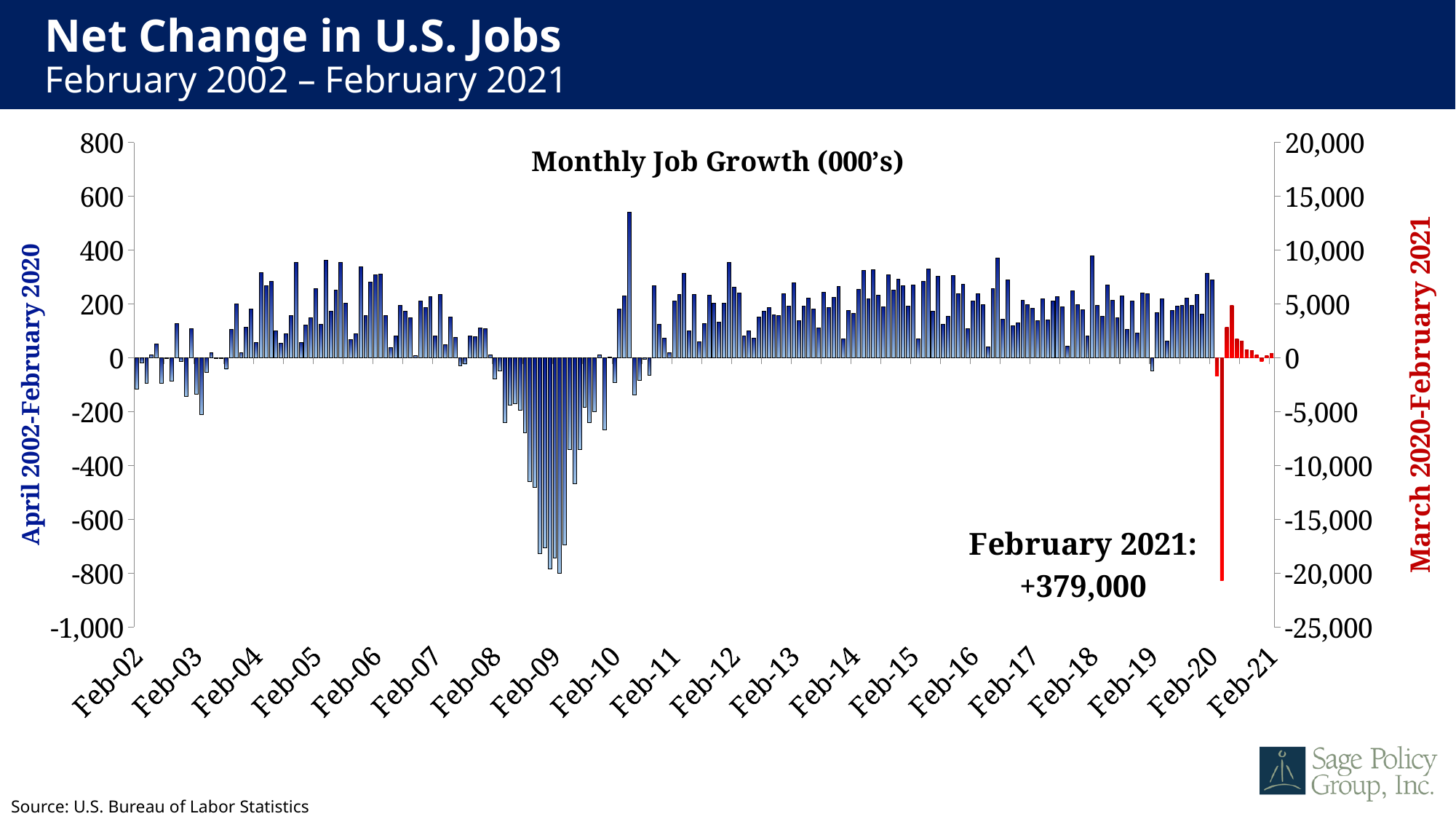
Which period do the red bars represent, according to the right-hand axis label? March 2020-February 2021 What is the lowest tick value shown on the right-hand y-axis? -25,000 What kind of chart is shown on the slide? Bar chart Is the value of the tallest blue bar (between Feb-10 and Feb-11) greater or less than 400 on the left-hand axis? greater Which is larger: the tallest blue bar between Feb-10 and Feb-11, or the tallest blue bar between Feb-17 and Feb-18? The bar between Feb-10 and Feb-11 What is the highest tick value shown on the left-hand y-axis? 800 What is the title printed inside the chart area? Monthly Job Growth (000's) Between Feb-08 and Feb-09, do the monthly job change values generally rise or fall? fall According to the annotation on the chart, what was the net change in U.S. jobs in February 2021? +379,000 Is the value of the lowest blue bar (around Feb-09) greater or less than -600 on the left-hand axis? less How many year labels (Feb-02 through Feb-21) are shown on the x-axis? 20 Is the value of the lowest red bar (just after Feb-20) greater or less than -15,000 on the right-hand axis? less